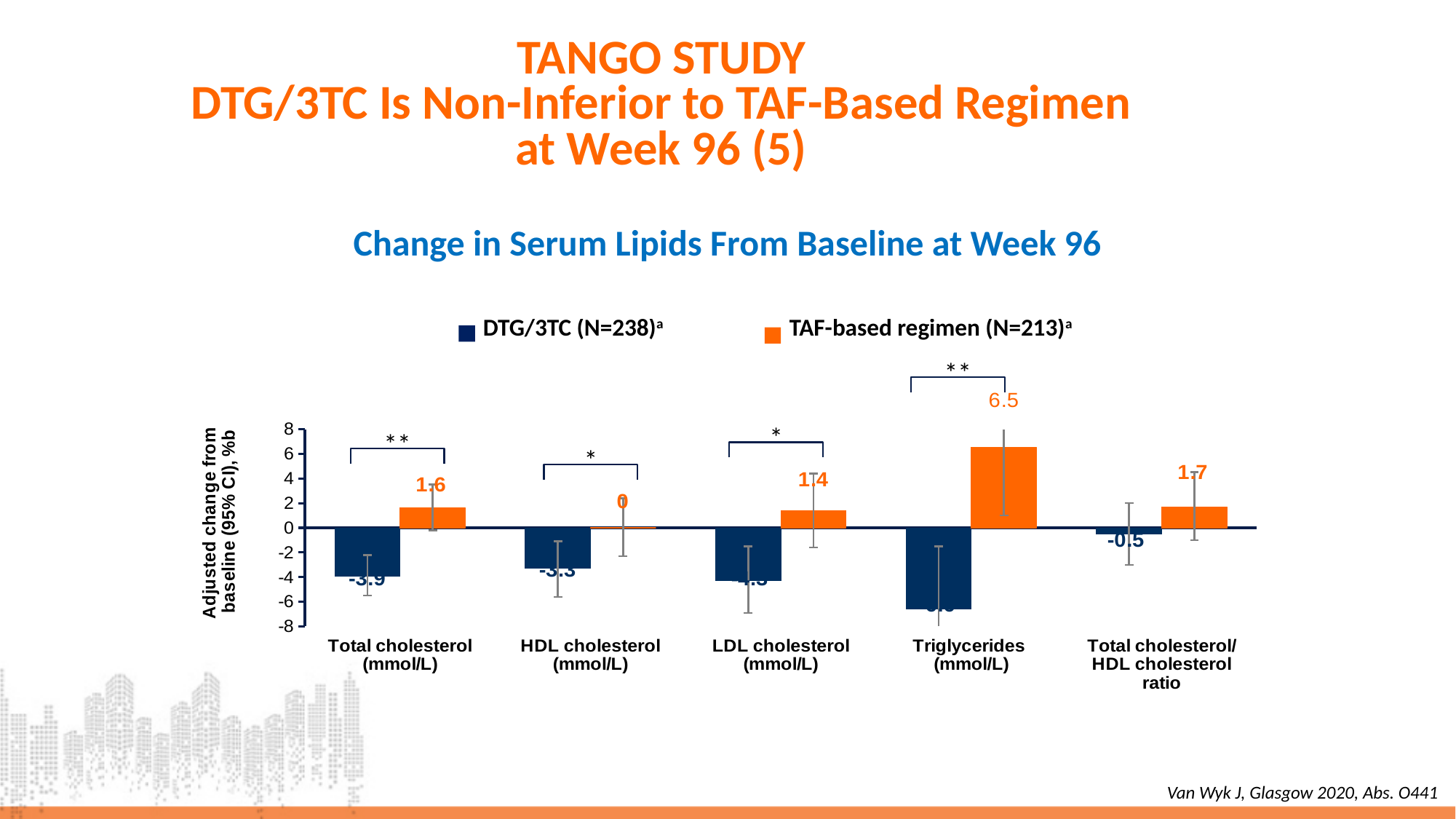
For the TAF-based regimen, which is larger: the total cholesterol value or the LDL cholesterol value? Total cholesterol What is the adjusted change from baseline in triglycerides for the TAF-based regimen? 6.5 How many lipid categories are shown on the x axis? 5 In which category does the TAF-based regimen have its highest value? Triglycerides (mmol/L) In which category does DTG/3TC have its lowest (most negative) value? Triglycerides (mmol/L) What is the adjusted change in HDL cholesterol for the TAF-based regimen? 0 What is the adjusted change in HDL cholesterol for DTG/3TC? -3.3 What is the difference between the TAF-based regimen and DTG/3TC values for total cholesterol? 5.5 What is the value for the TAF-based regimen in the total cholesterol/HDL cholesterol ratio category? 1.7 Is the DTG/3TC value for triglycerides greater or less than -4? less What is the adjusted change from baseline in total cholesterol for DTG/3TC? -3.9 How many series does the legend list? 2